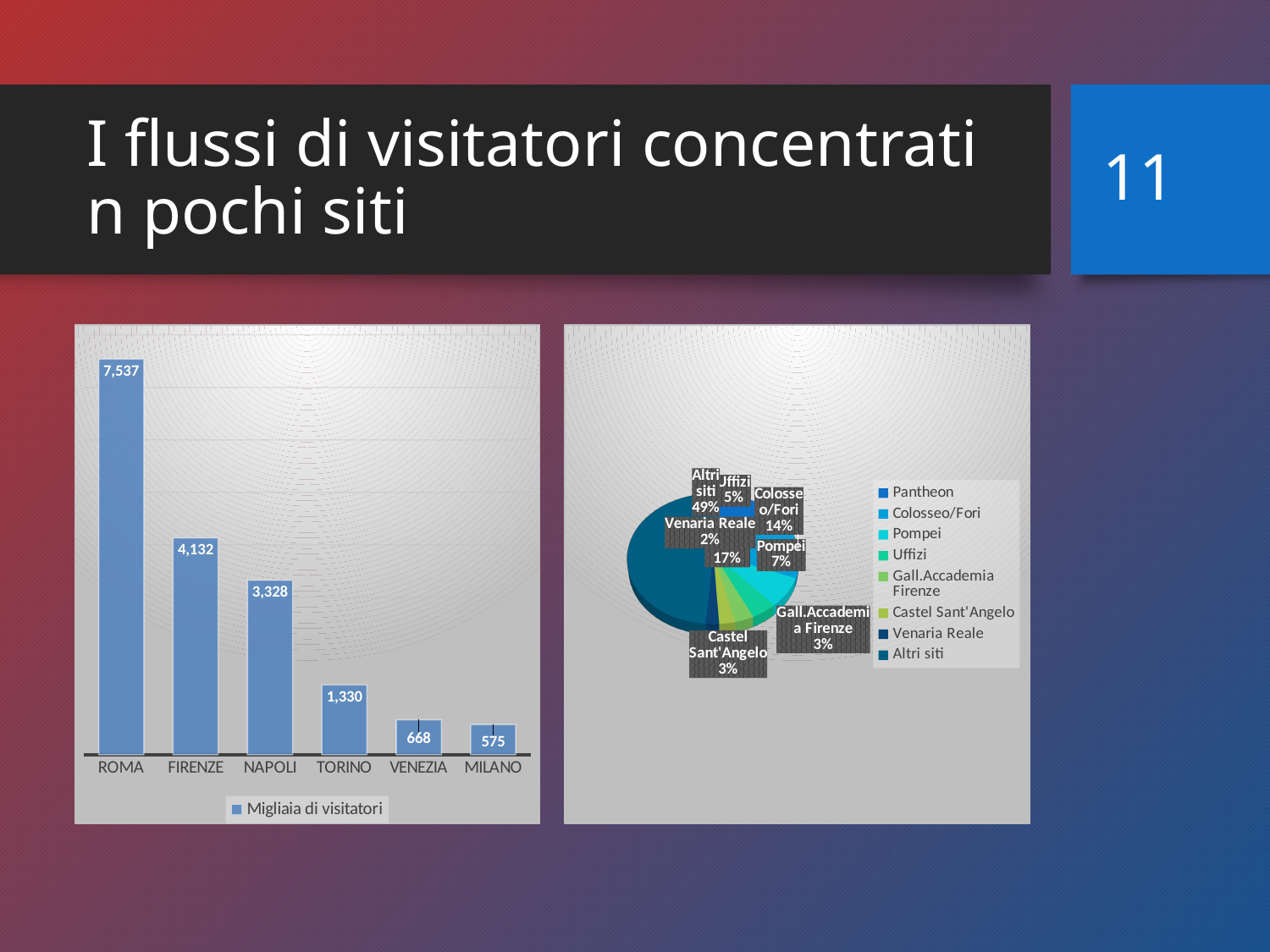
In the bar chart on the left, which city has the lowest value? MILANO In the bar chart on the left, which is larger, the value for VENEZIA or the value for MILANO? VENEZIA In the bar chart on the left, what is the value for ROMA? 7,537 What kind of chart is the chart on the left? Bar chart In the pie chart on the right, what share does Altri siti have? 49% In the bar chart on the left, what is the value for TORINO? 1,330 In the pie chart on the right, what share does Colosseo/Fori have? 14% How many entries does the legend of the pie chart on the right list? 8 In the bar chart on the left, what is the difference between the values for FIRENZE and NAPOLI? 804 How many cities are shown in the bar chart on the left? 6 In the bar chart on the left, what is the value for NAPOLI? 3,328 In the bar chart on the left, which city has the highest value? ROMA